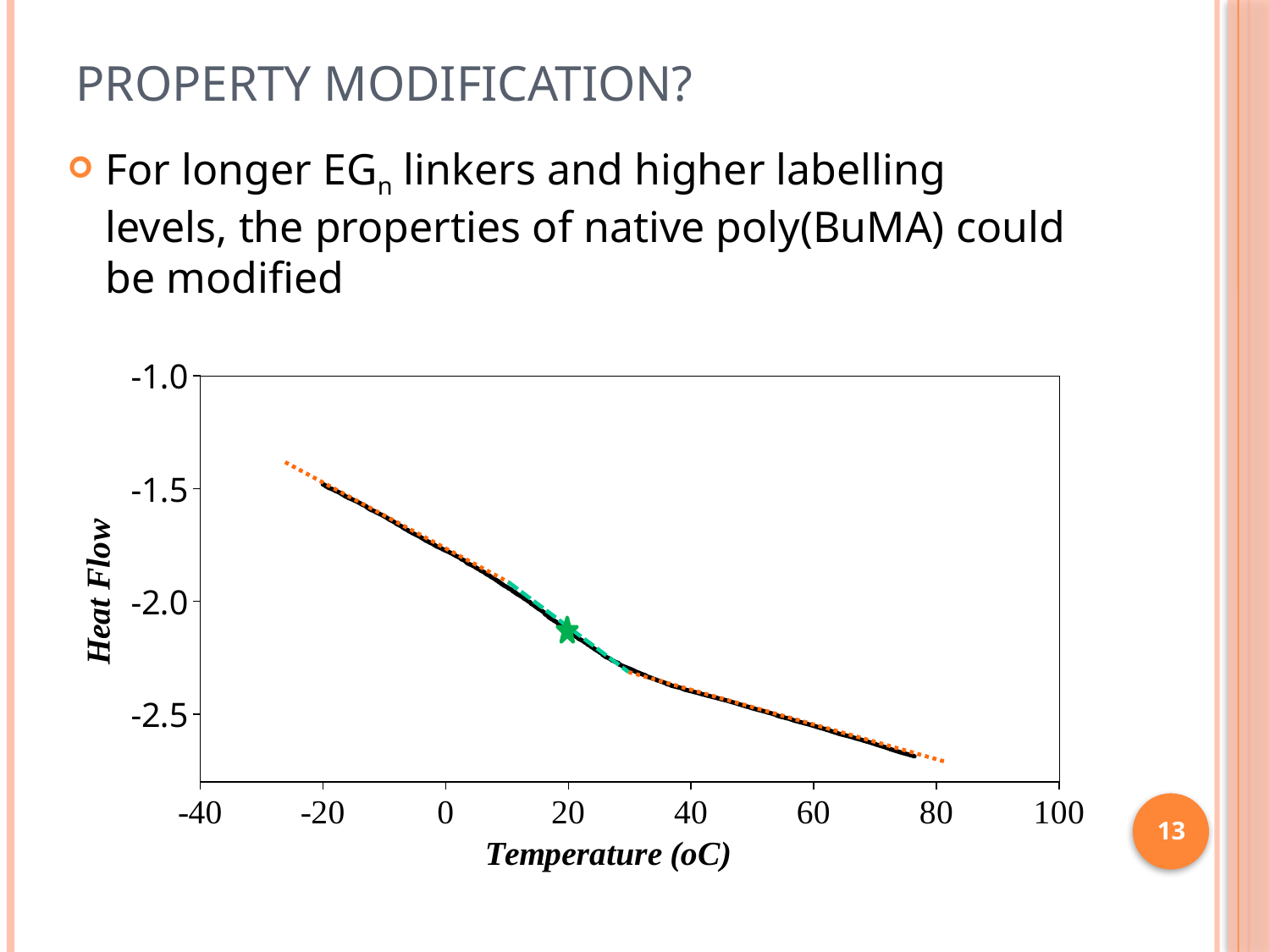
Is the heat flow at a temperature of 40 greater or less than -2.0? less Is the heat flow at a temperature of 0 greater or less than -2.0? greater Is the heat flow at a temperature of 40 greater or less than -2.5? greater Does the heat flow rise or fall as temperature increases along the x axis? fall What is the label of the y axis? Heat Flow What is the label of the x axis? Temperature (oC) Which has the higher heat flow: the curve at a temperature of 0 or at a temperature of 60? 0 What kind of chart is shown on the slide? line chart What is the highest temperature value shown on the x axis? 100